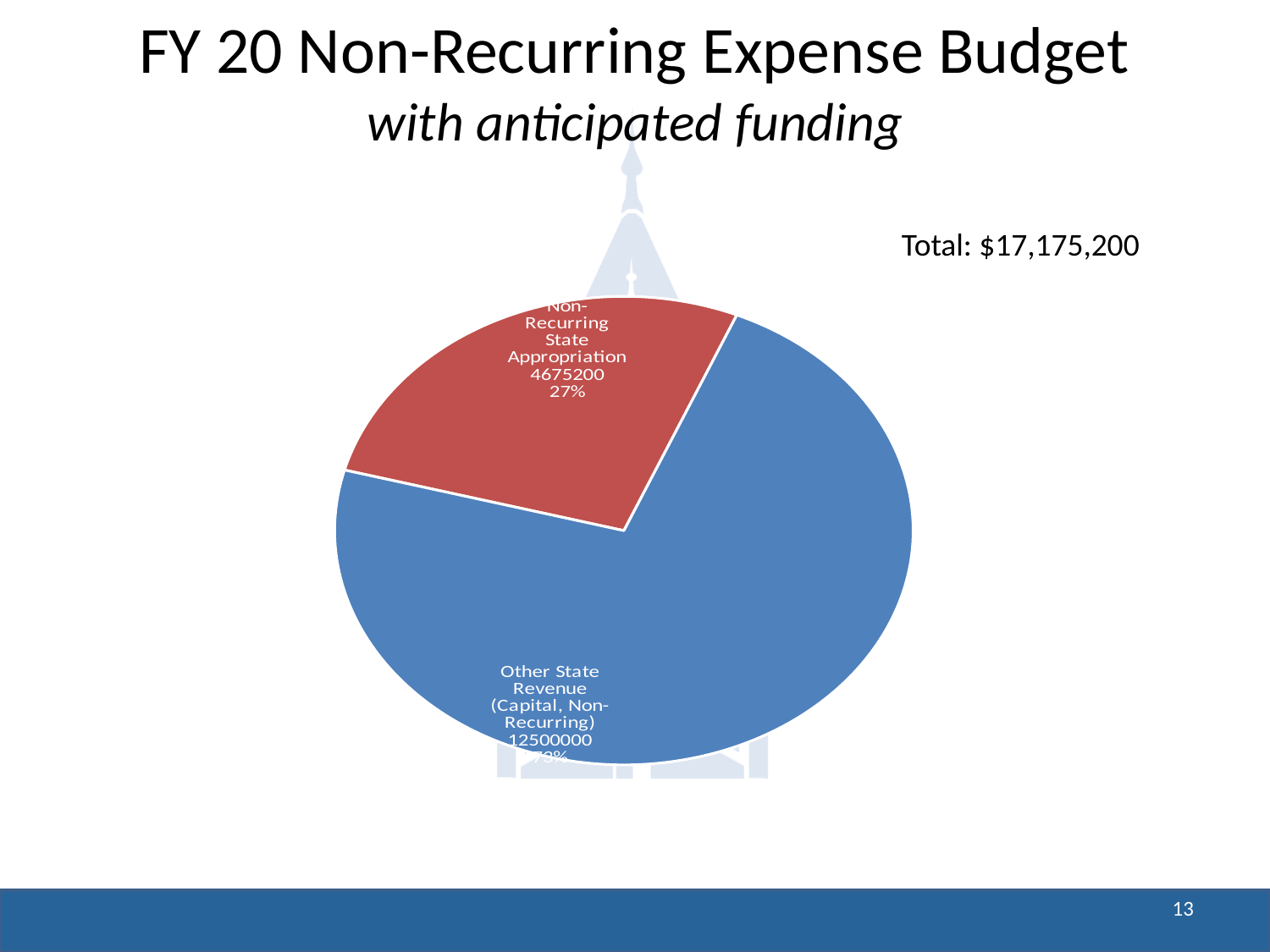
What is the difference between Other State Revenue (Capital, Non-Recurring) and Non-Recurring State Appropriation? 7824800 What colour is the Non-Recurring State Appropriation slice? red What total is stated on the slide for the FY 20 Non-Recurring Expense Budget? $17,175,200 Which slice is the largest? Other State Revenue (Capital, Non-Recurring) What is the value for Other State Revenue (Capital, Non-Recurring)? 12500000 What is the value for Non-Recurring State Appropriation? 4675200 Which slice is the smallest? Non-Recurring State Appropriation Which is larger, Non-Recurring State Appropriation or Other State Revenue (Capital, Non-Recurring)? Other State Revenue (Capital, Non-Recurring) What share of the pie does Non-Recurring State Appropriation represent? 27% What type of chart is shown on the slide? pie chart How many slices does the pie chart have? 2 What is the title of the slide containing the pie chart? FY 20 Non-Recurring Expense Budget with anticipated funding